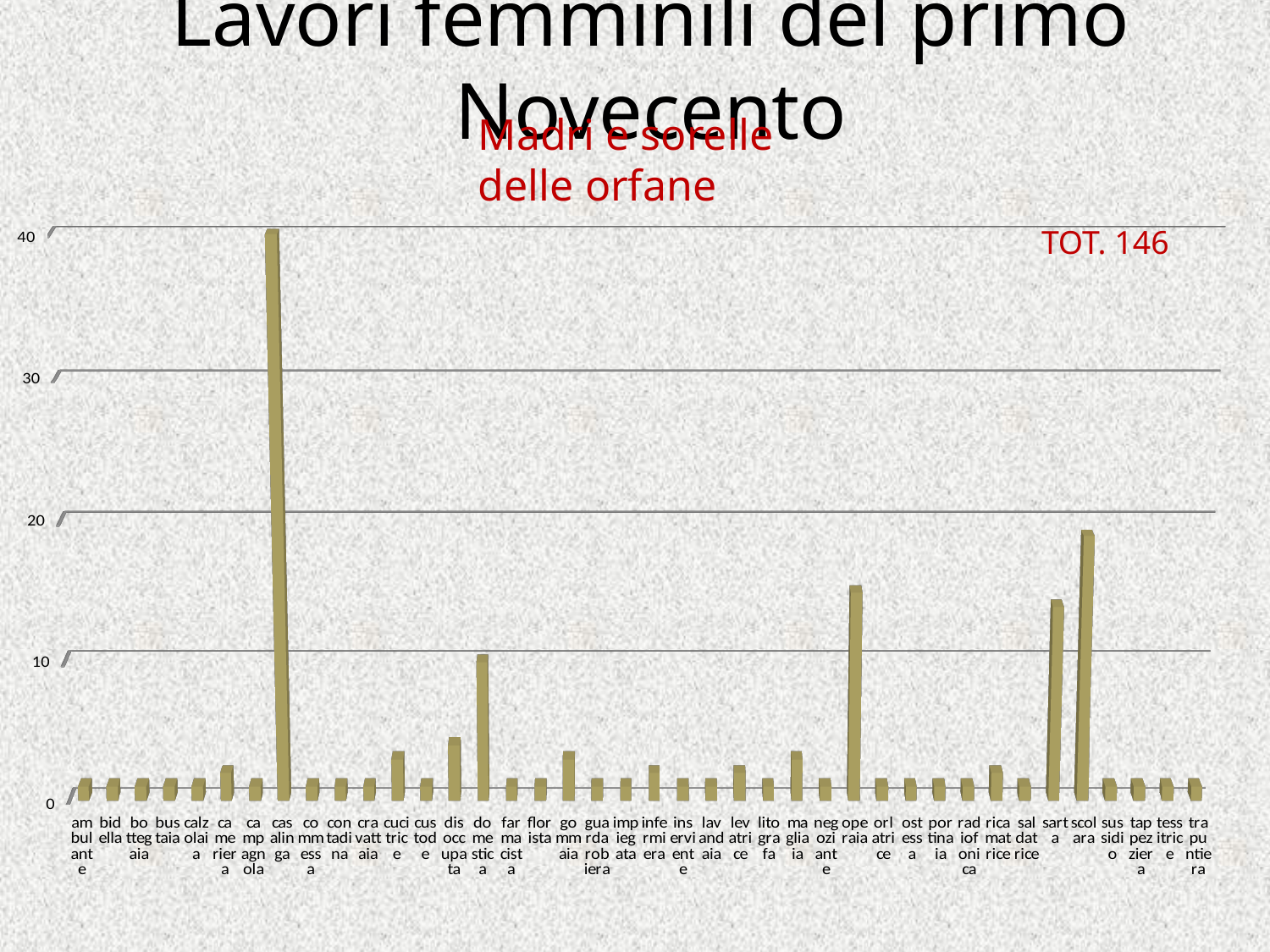
Is the value for scolara greater or less than 20? less What is the title of the slide? Lavori femminili del primo Novecento Which is larger, the value for casalinga or the value for scolara? casalinga Is the value for casalinga greater or less than 30? greater How many categories are plotted on the x axis? 40 Which is larger, the value for scolara or the value for operaia? scolara Is the value for cucitrice greater or less than 10? less Which category has the highest bar? casalinga What total is printed in red on the chart? TOT. 146 What kind of chart is shown on the slide? bar chart